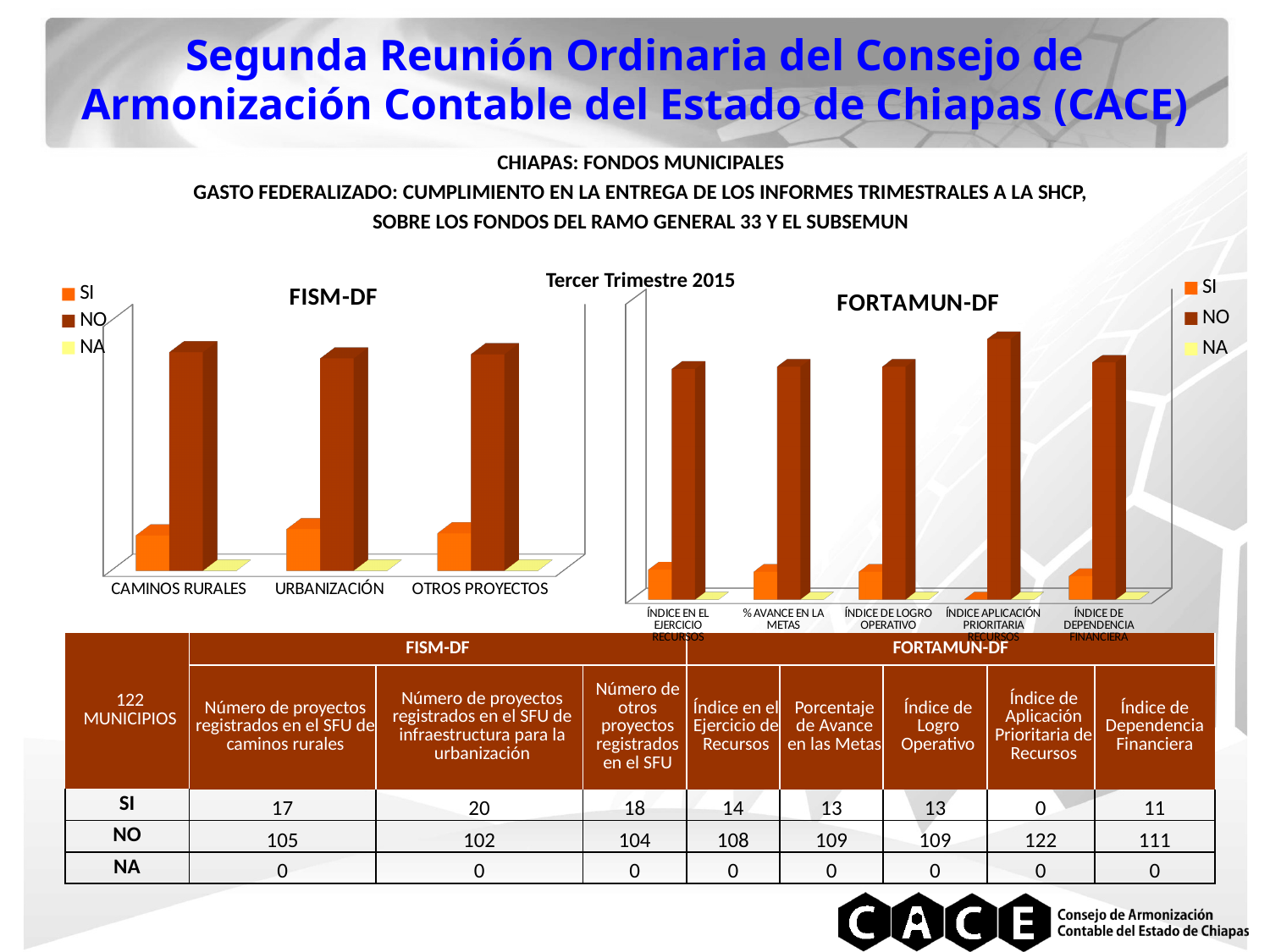
In the FORTAMUN-DF chart, what is the NO value for ÍNDICE DE DEPENDENCIA FINANCIERA? 111 In the FISM-DF chart, what is the NO value for CAMINOS RURALES? 105 In the FISM-DF chart, what is the difference between the NO and SI values for CAMINOS RURALES? 88 What type of chart is the FISM-DF chart? bar chart How many categories are shown on the x axis of the FISM-DF chart? 3 What are the three legend entries of the FISM-DF chart? SI, NO, NA In the FORTAMUN-DF chart, which category has the tallest NO bar? ÍNDICE APLICACIÓN PRIORITARIA RECURSOS In the FISM-DF chart, is the NO bar or the SI bar larger for CAMINOS RURALES? NO How many categories are shown on the x axis of the FORTAMUN-DF chart? 5 How many series does the legend of the FORTAMUN-DF chart list? 3 In the FORTAMUN-DF chart, which category has the lowest SI value? ÍNDICE APLICACIÓN PRIORITARIA RECURSOS In the FISM-DF chart, what is the SI value for URBANIZACIÓN? 20